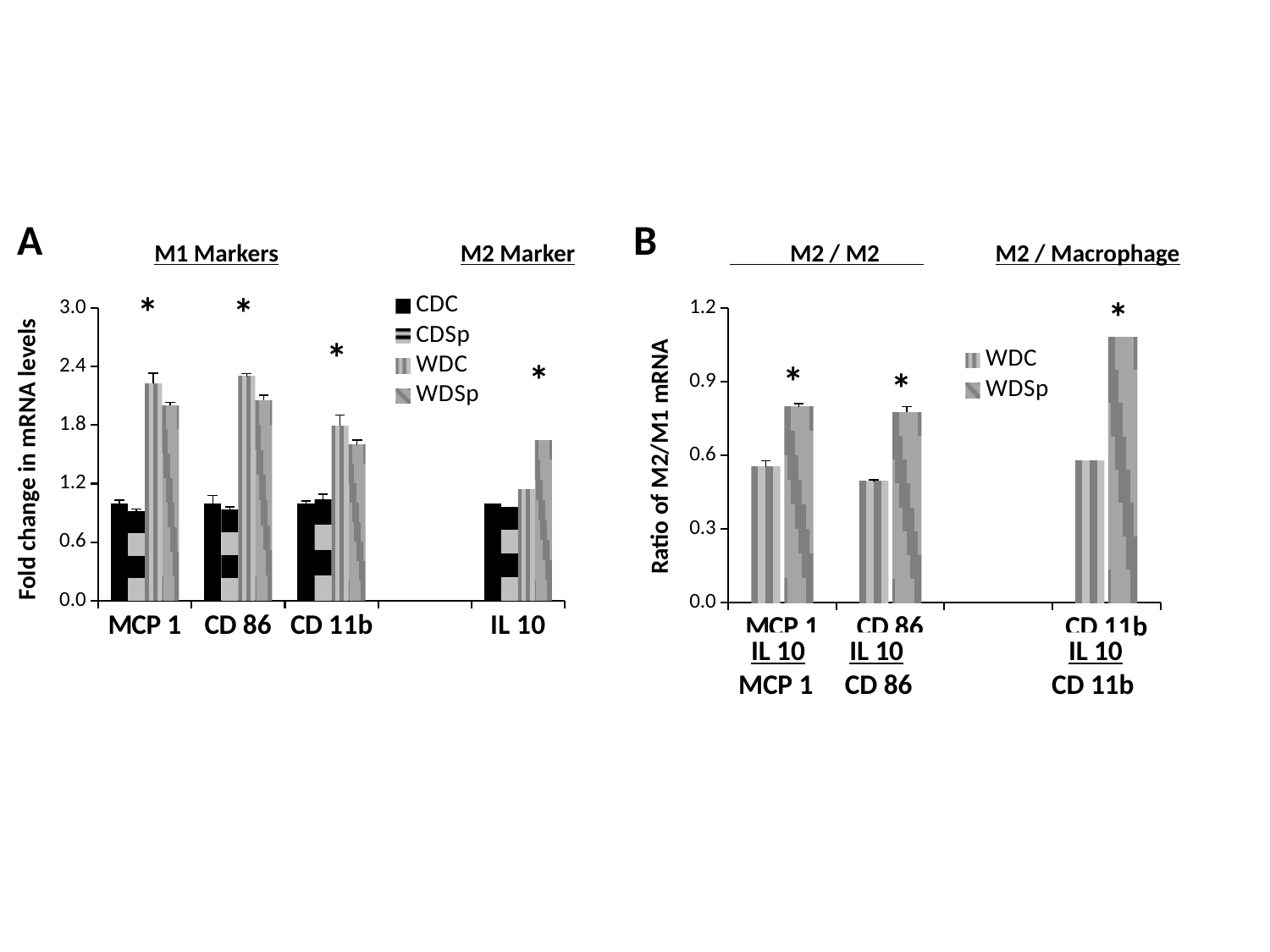
On chart B (right), is the WDSp value for CD 11b greater or less than 0.9? greater On chart B (right), which category has the highest WDSp value? CD 11b On chart A (left), how many series does the legend list? 4 On chart A (left), for IL 10, which is larger: WDC or WDSp? WDSp On chart A (left), how many categories are shown on the x axis? 4 On chart B (right), how many series does the legend list? 2 On chart A (left), is the WDSp value for CD 11b greater or less than 1.8? less On chart A (left), what kind of chart is shown? bar chart On chart A (left), is the WDC value for MCP 1 greater or less than 1.8? greater On chart B (right), how many categories are plotted? 3 On chart B (right), what is the y-axis title? Ratio of M2/M1 mRNA On chart A (left), for CD 86, which is larger: WDC or WDSp? WDC